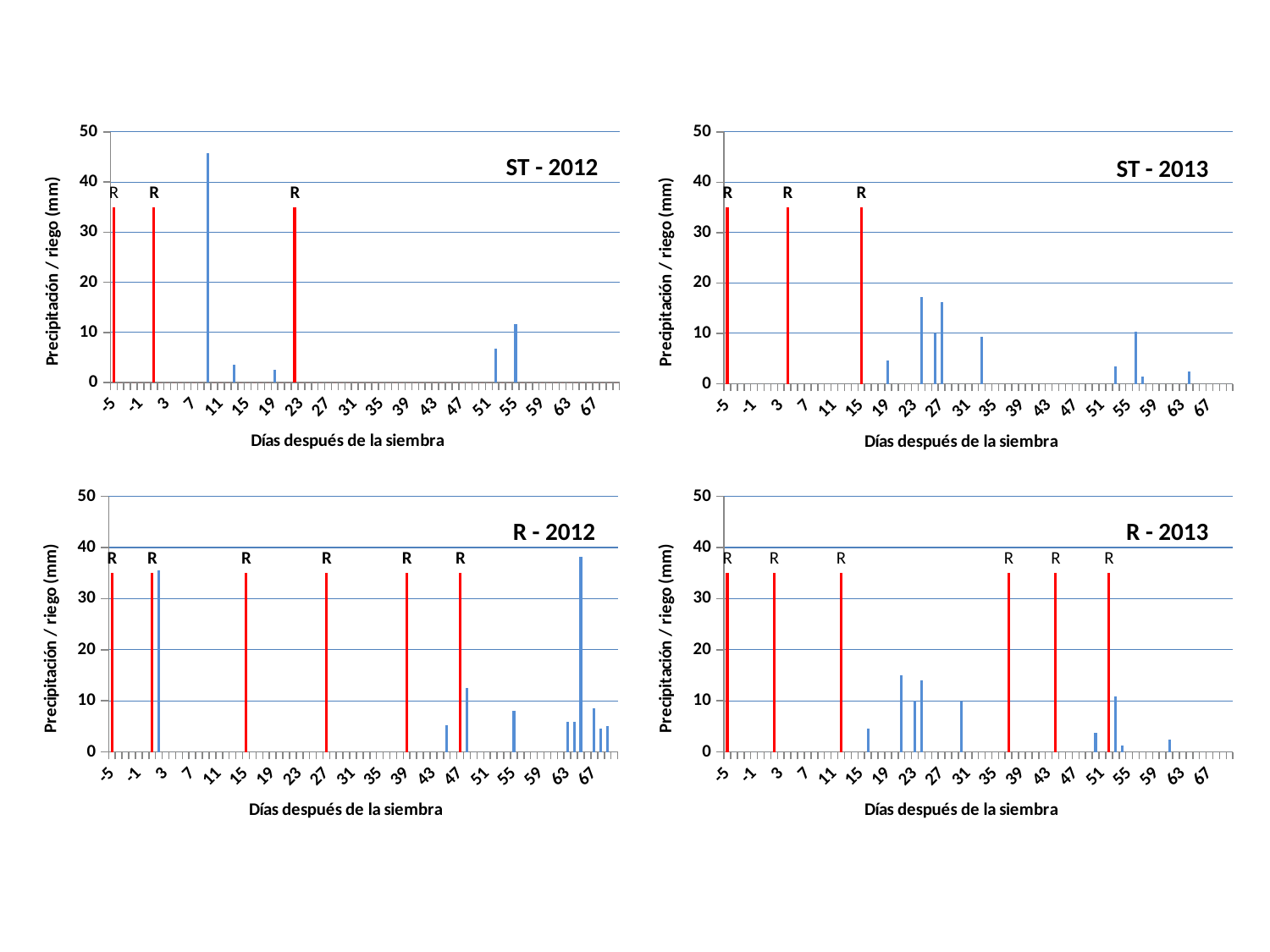
In the R - 2013 chart, how many red bars marked R are shown? 6 What is the x-axis label on the R - 2013 chart? Días después de la siembra What kind of chart is the ST - 2012 chart? Bar chart In the R - 2013 chart, is the tallest blue bar greater or less than 20? less In the ST - 2013 chart, is the tallest blue bar greater or less than 20? less What is the y-axis label on the ST - 2012 chart? Precipitación / riego (mm) In the ST - 2013 chart, how many red bars marked R are shown? 3 In the R - 2012 chart, how many red bars marked R are shown? 6 In the R - 2012 chart, is the tallest blue bar greater or less than 30? greater Which chart has the taller tallest blue bar, ST - 2012 or ST - 2013? ST - 2012